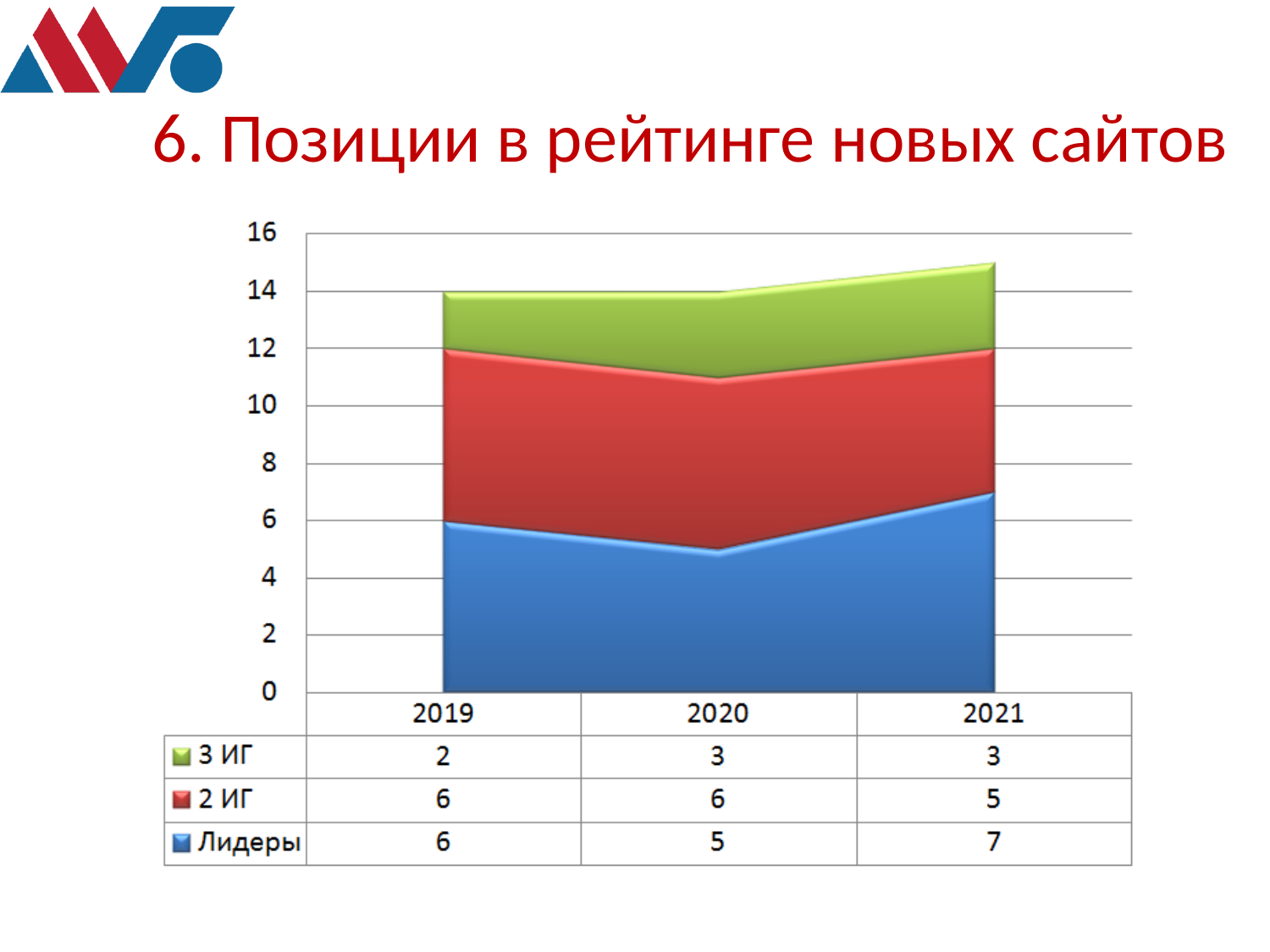
What is the difference between the Лидеры values for 2021 and 2020? 2 In which year is the value for Лидеры highest? 2021 What is the value for 2 ИГ in 2020? 6 How many series does the legend list? 3 What is the value for Лидеры in 2021? 7 What kind of chart is shown on the slide? stacked area chart What is the total of all three series in 2021? 15 What is the total of all three series in 2019? 14 What is the value for 3 ИГ in 2019? 2 In which year is the value for Лидеры lowest? 2020 How many years are shown on the x axis? 3 Which is larger, the 2 ИГ value in 2019 or the 2 ИГ value in 2021? 2019